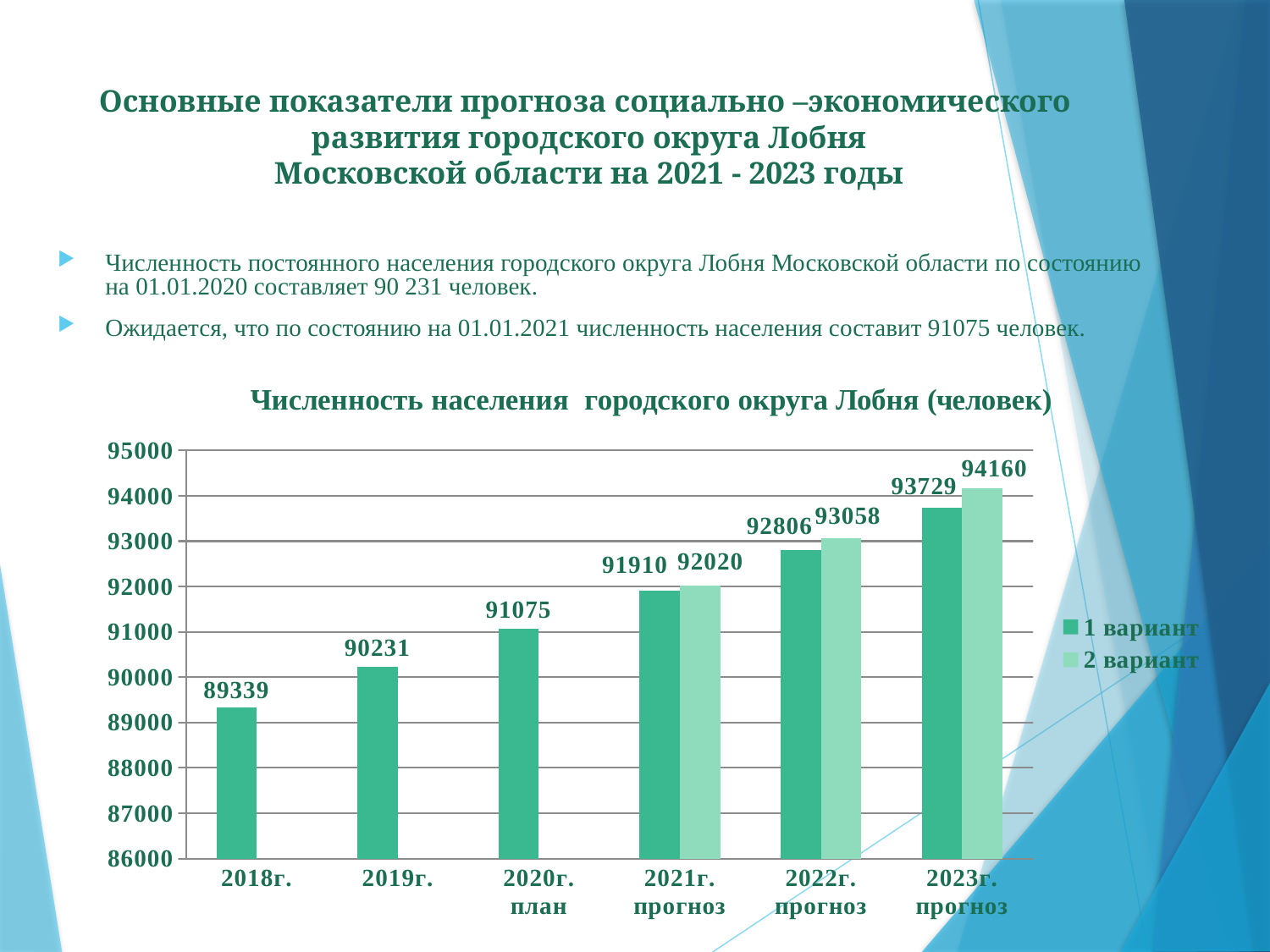
What is the value of the '2 вариант' series for 2023г. прогноз? 94160 How many series does the legend list? 2 What is the difference between the values for 2020г. план and 2019г.? 844 Do the '1 вариант' values rise or fall from 2018г. to 2023г. прогноз? rise Which category has the highest value in the chart? 2023г. прогноз How many categories are shown on the x axis of the chart? 6 What kind of chart is shown on the slide? bar chart What is the difference between the '2 вариант' and '1 вариант' values for 2021г. прогноз? 110 Which category has the lowest value in the chart? 2018г. What is the value for 2018г. in the chart? 89339 Which is larger: the '1 вариант' value for 2023г. прогноз or the '2 вариант' value for 2022г. прогноз? 1 вариант for 2023г. прогноз What is the value of the '1 вариант' series for 2022г. прогноз? 92806